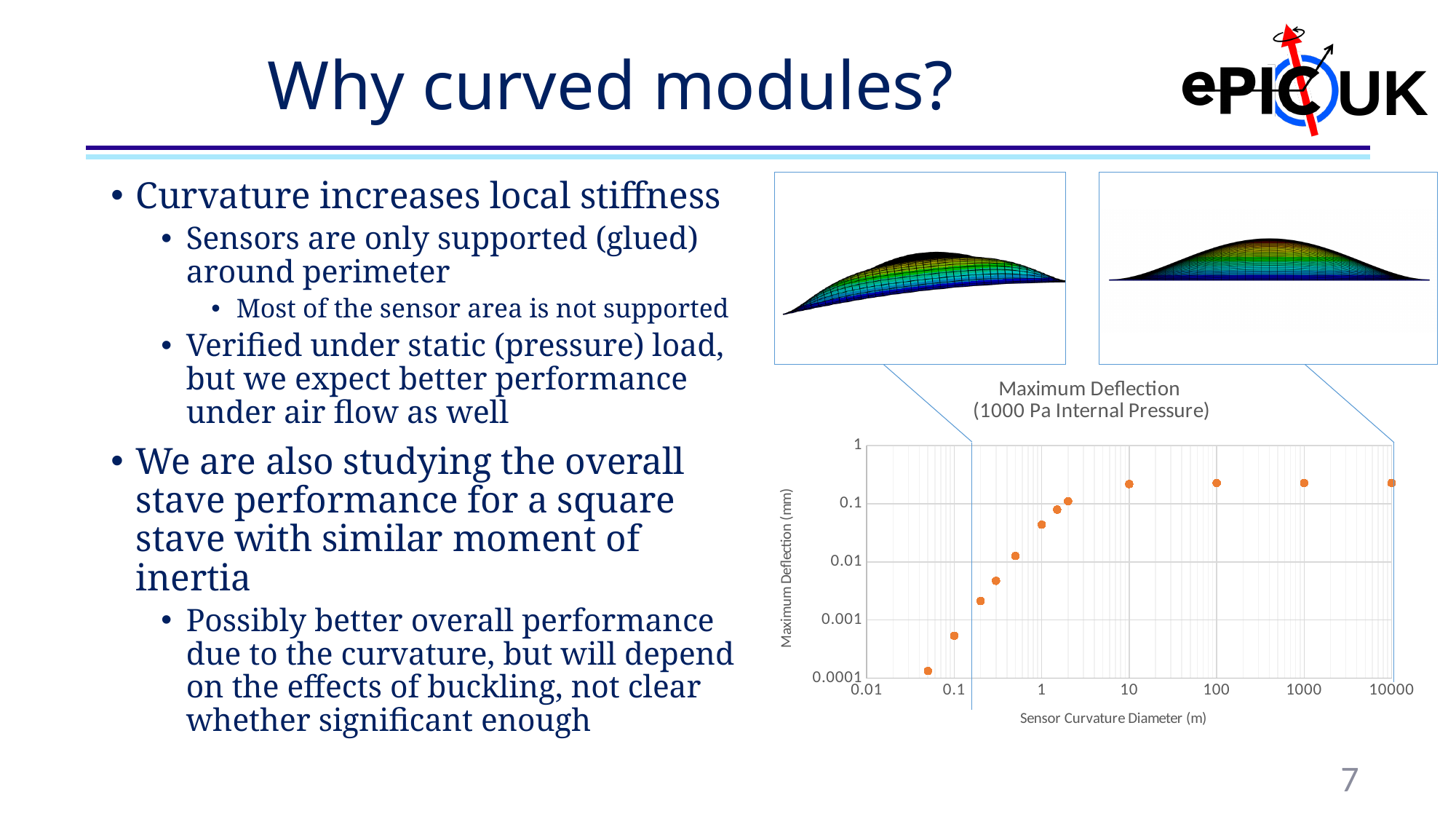
Is the maximum deflection at a sensor curvature diameter of 1 m greater or less than 0.01 mm? greater What kind of chart is shown on the slide? scatter chart Is the maximum deflection at a sensor curvature diameter of 100 m greater or less than 0.1 mm? greater What is the label of the x axis of the chart? Sensor Curvature Diameter (m) Is the maximum deflection at a sensor curvature diameter of 0.1 m greater or less than 0.001 mm? less Does the maximum deflection rise or fall as the sensor curvature diameter increases? rise Which has the larger maximum deflection: the point at 1 m or the point at 10 m sensor curvature diameter? 10 m Is the lowest maximum deflection found at the smallest or the largest sensor curvature diameter? smallest How many data points are plotted on the chart? 12 What is the title of the chart? Maximum Deflection (1000 Pa Internal Pressure)